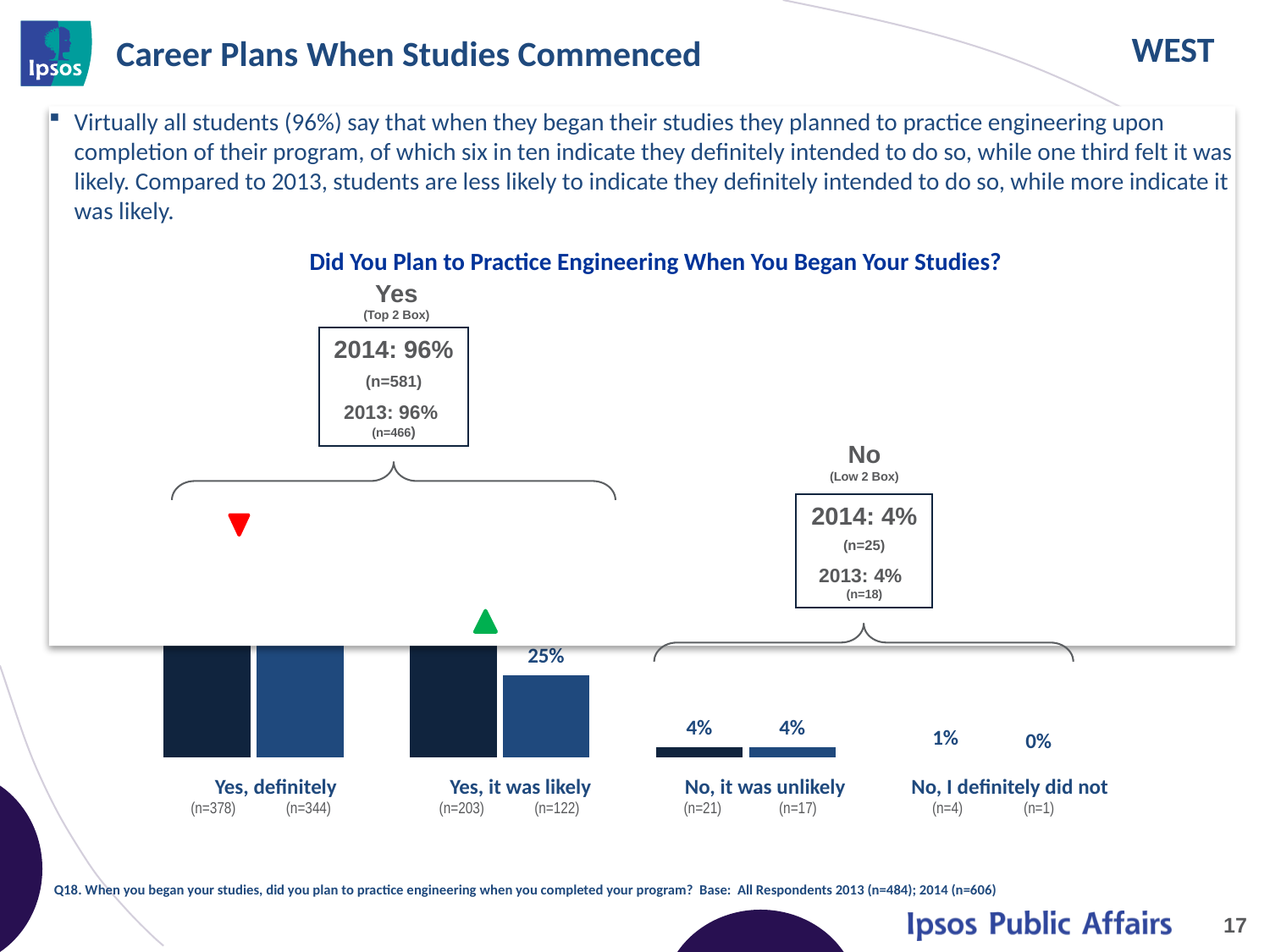
Which category has the tallest bars in the chart? Yes, definitely Which category has the lowest printed value in the chart? No, I definitely did not What value is printed on the dark blue bar for "No, it was unlikely"? 4% What value is printed on the dark blue bar for "No, I definitely did not"? 1% What value is printed on the lighter blue bar for "Yes, it was likely"? 25% What kind of chart is shown on the slide? bar chart What value is printed on the lighter blue bar for "No, I definitely did not"? 0% According to the "Yes (Top 2 Box)" annotation, what is the 2014 value? 96% What is the difference between the lighter blue bar for "Yes, it was likely" (25%) and the lighter blue bar for "No, it was unlikely" (4%)? 21% Which is larger for "No, I definitely did not": the dark blue bar or the lighter blue bar? the dark blue bar How many response categories are shown along the x axis of the chart? 4 What is the title of the chart? Did You Plan to Practice Engineering When You Began Your Studies?